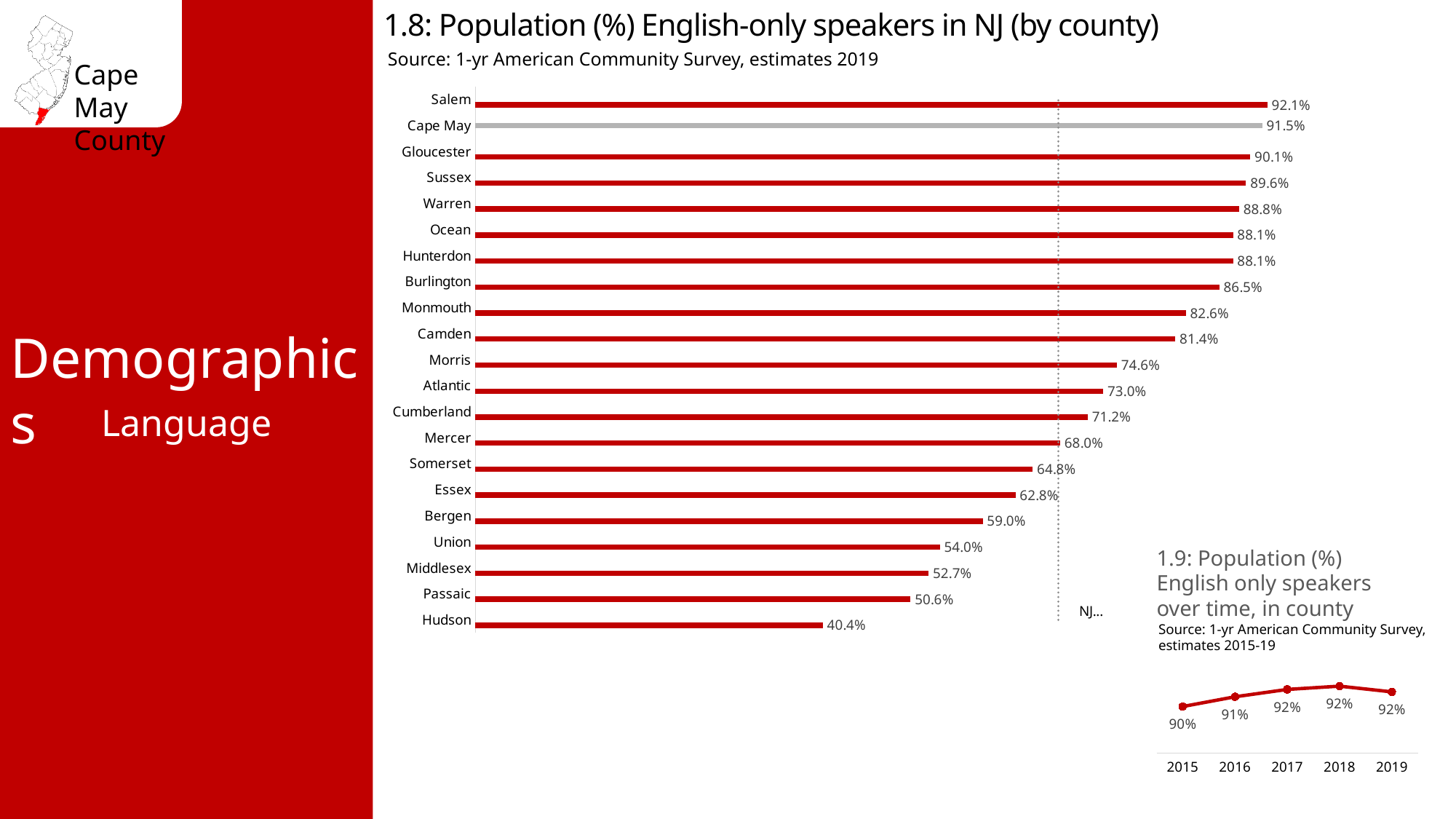
In chart 1.8, how many counties are shown? 21 What kind of chart is chart 1.8? Bar chart What kind of chart is chart 1.9? Line chart In chart 1.8, what is the difference between Salem and Cape May? 0.6% In chart 1.8, what is the value for Hudson? 40.4% In chart 1.8, which county has the highest percentage of English-only speakers? Salem In chart 1.8, what is the value for Cape May? 91.5% In chart 1.9, how many years are plotted? 5 In chart 1.9, what is the value for 2015? 90% In chart 1.8, which is larger, the value for Morris or the value for Bergen? Morris In chart 1.8, which county has the lowest percentage of English-only speakers? Hudson In chart 1.8, which county's bar is coloured grey instead of red? Cape May